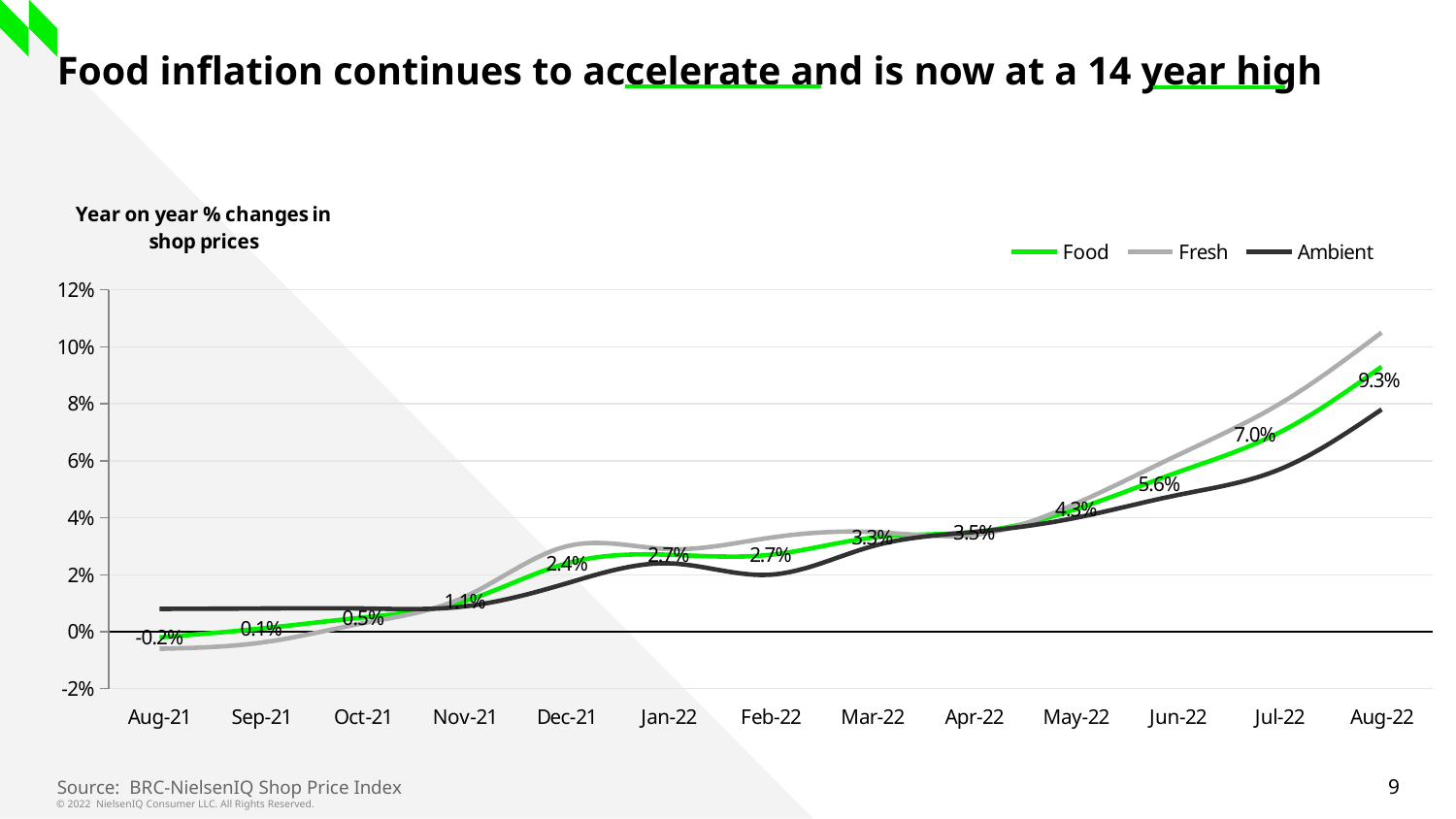
In which month is the Food series lowest? Aug-21 In which month is the Food series highest? Aug-22 Is the Ambient value for Aug-22 greater or less than 8%? less Which is larger for Food: the value for May-22 or the value for Jun-22? Jun-22 How many series does the legend list? 3 Is the Fresh value for Aug-22 greater or less than 10%? greater What is the Food value for Aug-22? 9.3% What is the Food value for Aug-21? -0.2% What is the Food value for Dec-21? 2.4% What kind of chart is shown on the slide? Line chart How many months are shown on the x axis? 13 What is the difference between the Food values for Aug-22 and Jul-22? 2.3%